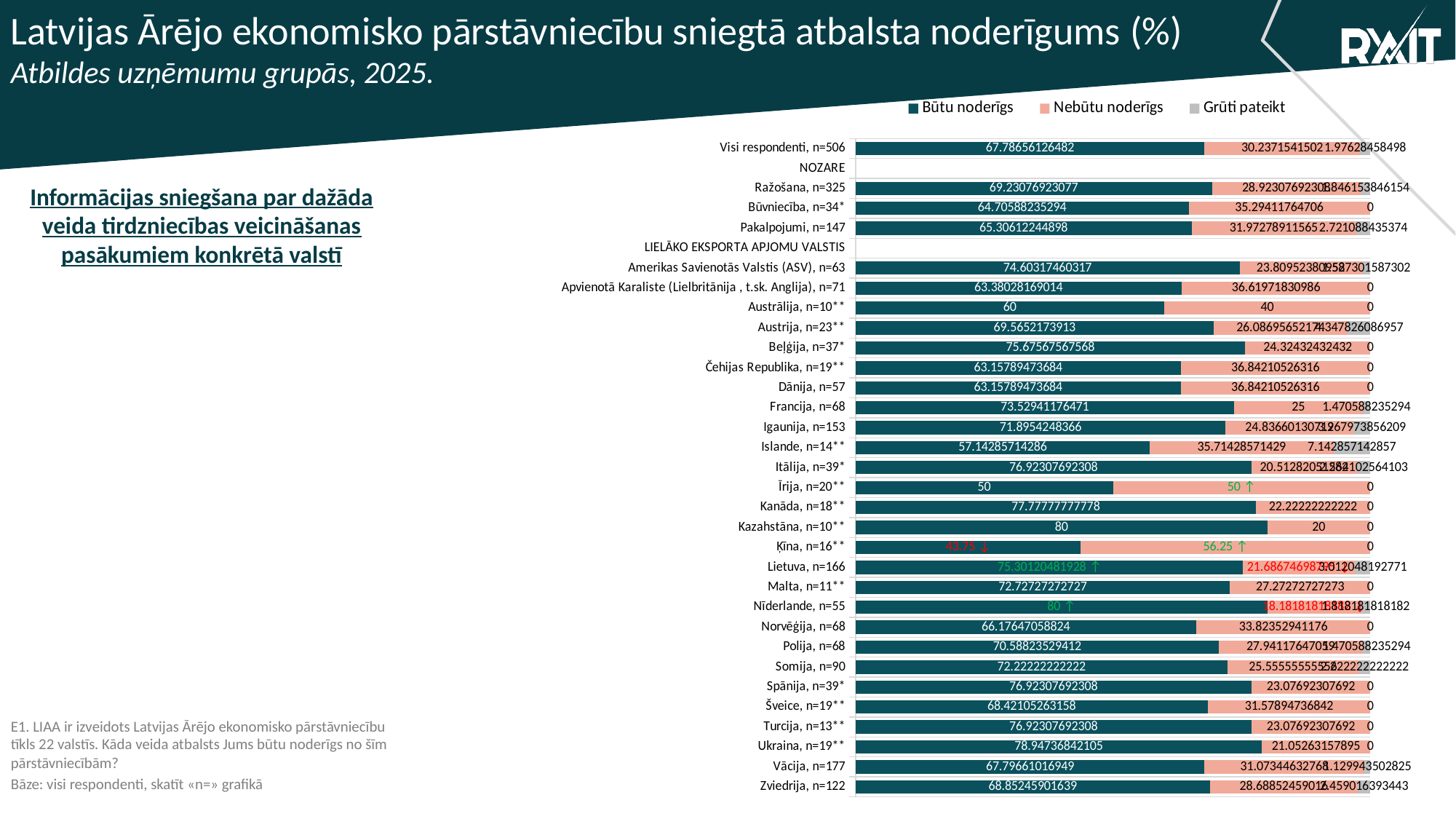
Which category has the lowest 'Būtu noderīgs' value? Ķīna, n=16** What is the 'Būtu noderīgs' value for Kazahstāna, n=10**? 80 What is the 'Nebūtu noderīgs' value for Francija, n=68? 25 How many countries are listed under 'LIELĀKO EKSPORTA APJOMU VALSTIS'? 27 What kind of chart is shown on the slide? Stacked bar chart What is the 'Būtu noderīgs' value for Ķīna, n=16**? 43.75 What is the total of the stacked bar for Īrija, n=20**? 100 What is the difference between the 'Būtu noderīgs' and 'Nebūtu noderīgs' values for Kazahstāna, n=10**? 60 How many series does the legend list? 3 What is the 'Nebūtu noderīgs' value for Austrālija, n=10**? 40 Which has the larger 'Būtu noderīgs' value, Austrālija, n=10** or Kazahstāna, n=10**? Kazahstāna, n=10** Which category has the highest 'Nebūtu noderīgs' value? Ķīna, n=16**